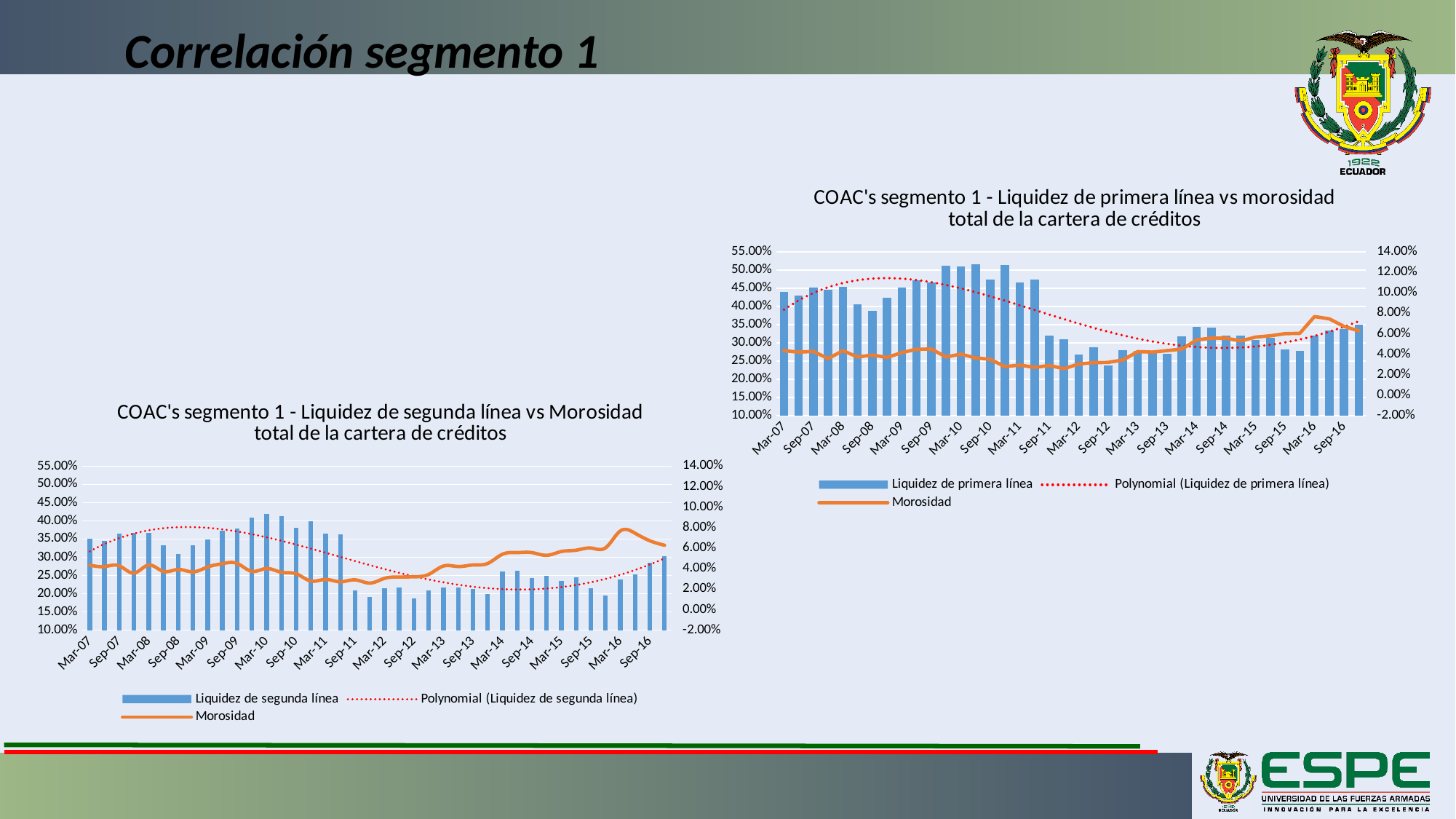
In the right chart, 'Liquidez de primera línea vs morosidad', which is larger: the bar for Mar-10 or the bar for Sep-12? Mar-10 In the right chart, 'Liquidez de primera línea vs morosidad', which series is drawn as a dotted red line according to the legend? Polynomial (Liquidez de primera línea) How many date labels are shown on the x axis of the left chart, 'Liquidez de segunda línea vs Morosidad'? 20 How many entries does the legend of the left chart, 'Liquidez de segunda línea vs Morosidad', list? 3 What kind of chart is the left chart, 'COAC's segmento 1 - Liquidez de segunda línea vs Morosidad total de la cartera de créditos'? A combined bar and line chart How many entries does the legend of the right chart, 'COAC's segmento 1 - Liquidez de primera línea vs morosidad total de la cartera de créditos', list? 3 In the right chart, 'Liquidez de primera línea vs morosidad', is the bar for Sep-12 greater or less than 30.00%? less In the left chart, 'Liquidez de segunda línea vs Morosidad', is the bar for Mar-07 greater or less than 30.00%? greater In the left chart, 'Liquidez de segunda línea vs Morosidad', is the bar for Sep-12 greater or less than 20.00%? less In the left chart, 'Liquidez de segunda línea vs Morosidad', does the Morosidad line rise or fall between Sep-12 and Mar-16? rise In the right chart, 'Liquidez de primera línea vs morosidad', do the bars rise or fall between Mar-11 and Sep-12? fall